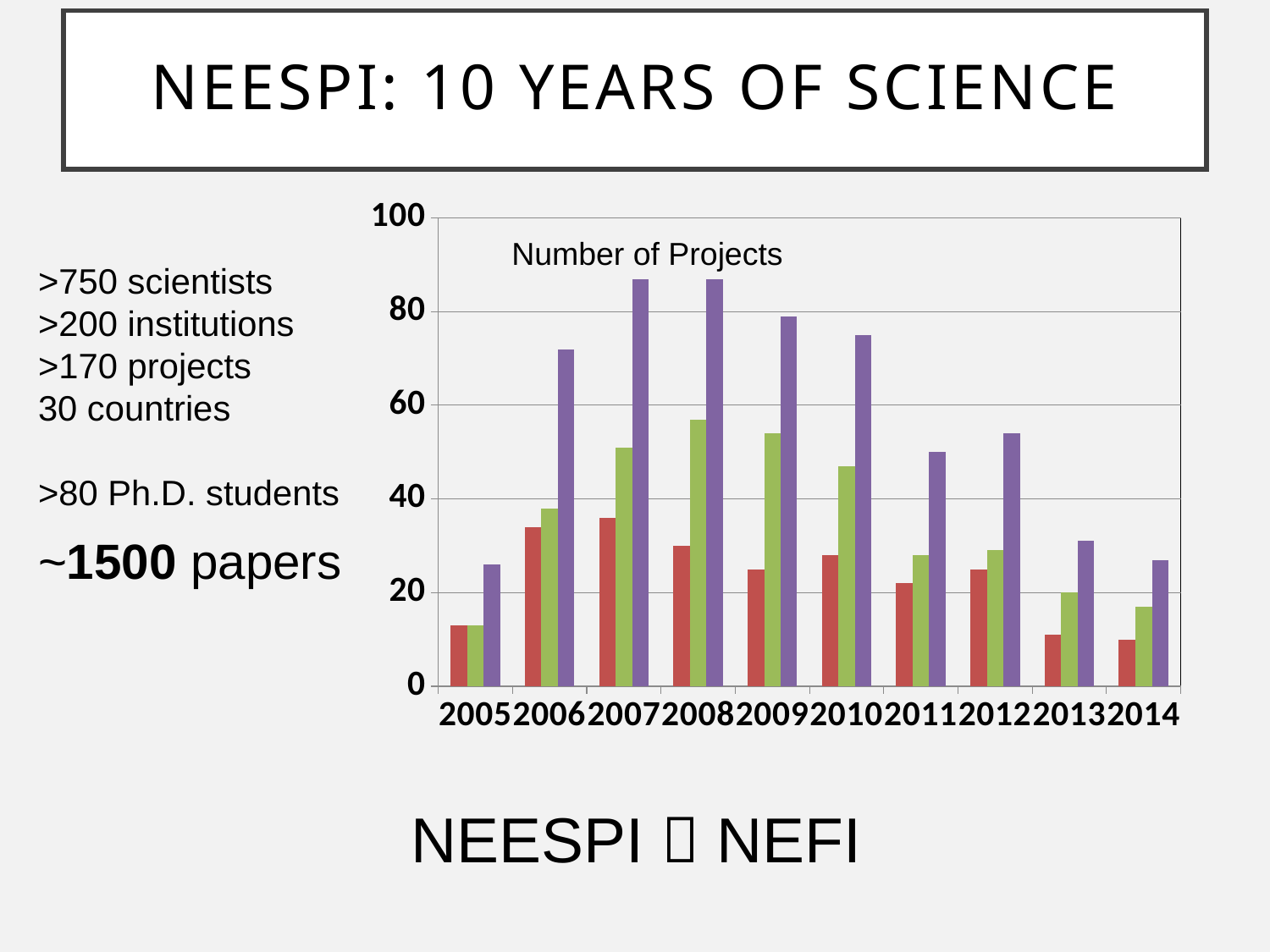
Is the value of the green bar for 2008 greater or less than 40? greater Which is larger, the purple bar for 2007 or the purple bar for 2011? 2007 Is the value of the red bar for 2005 greater or less than 20? less Do the green bars rise or fall from 2005 to 2008? rise Is the value of the purple bar for 2014 greater or less than 20? greater How many bars are plotted for each year in the chart? 3 How many years are shown on the x axis of the chart? 10 What kind of chart is shown on the slide? bar chart What is the title of the chart? Number of Projects Do the purple bars rise or fall from 2012 to 2014? fall